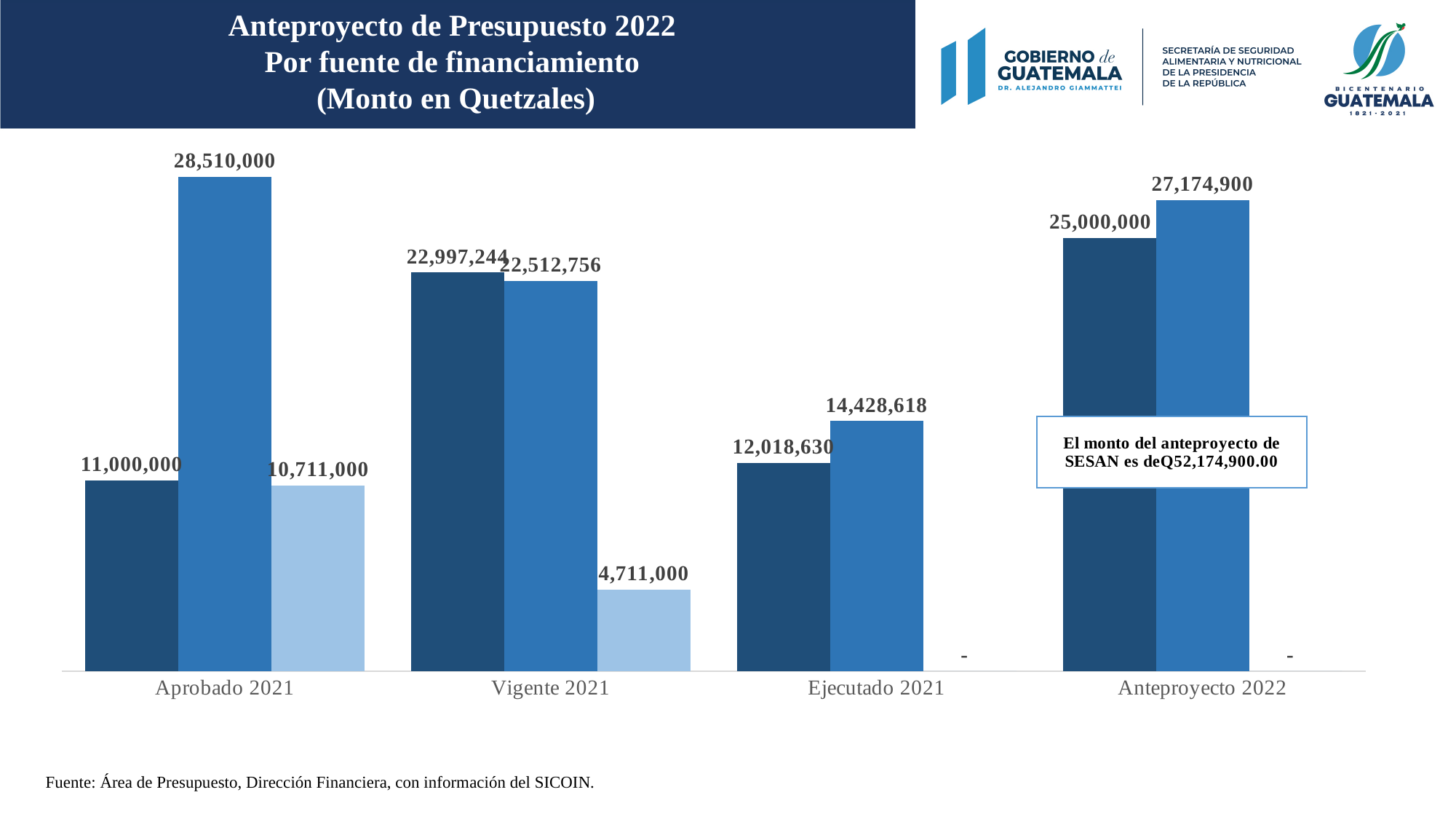
What is the value of the medium blue (second) bar for Anteproyecto 2022? 27,174,900 Which category has the lowest labelled bar in the chart? Vigente 2021 Which category has the highest single bar in the chart? Aprobado 2021 How many categories are shown along the x axis of the chart? 4 What is the difference between the medium blue bar and the dark blue bar for Anteproyecto 2022? 2,174,900 For Vigente 2021, which is larger: the dark blue bar or the medium blue bar? the dark blue bar According to the text box on the chart, what is the total amount of the SESAN anteproyecto? Q52,174,900.00 What is the value of the dark blue (first) bar for Ejecutado 2021? 12,018,630 What is the value of the light blue (third) bar for Vigente 2021? 4,711,000 What kind of chart is shown on the slide? bar chart What is the difference between the medium blue bar and the dark blue bar for Aprobado 2021? 17,510,000 What is the value of the medium blue (second) bar for Aprobado 2021? 28,510,000